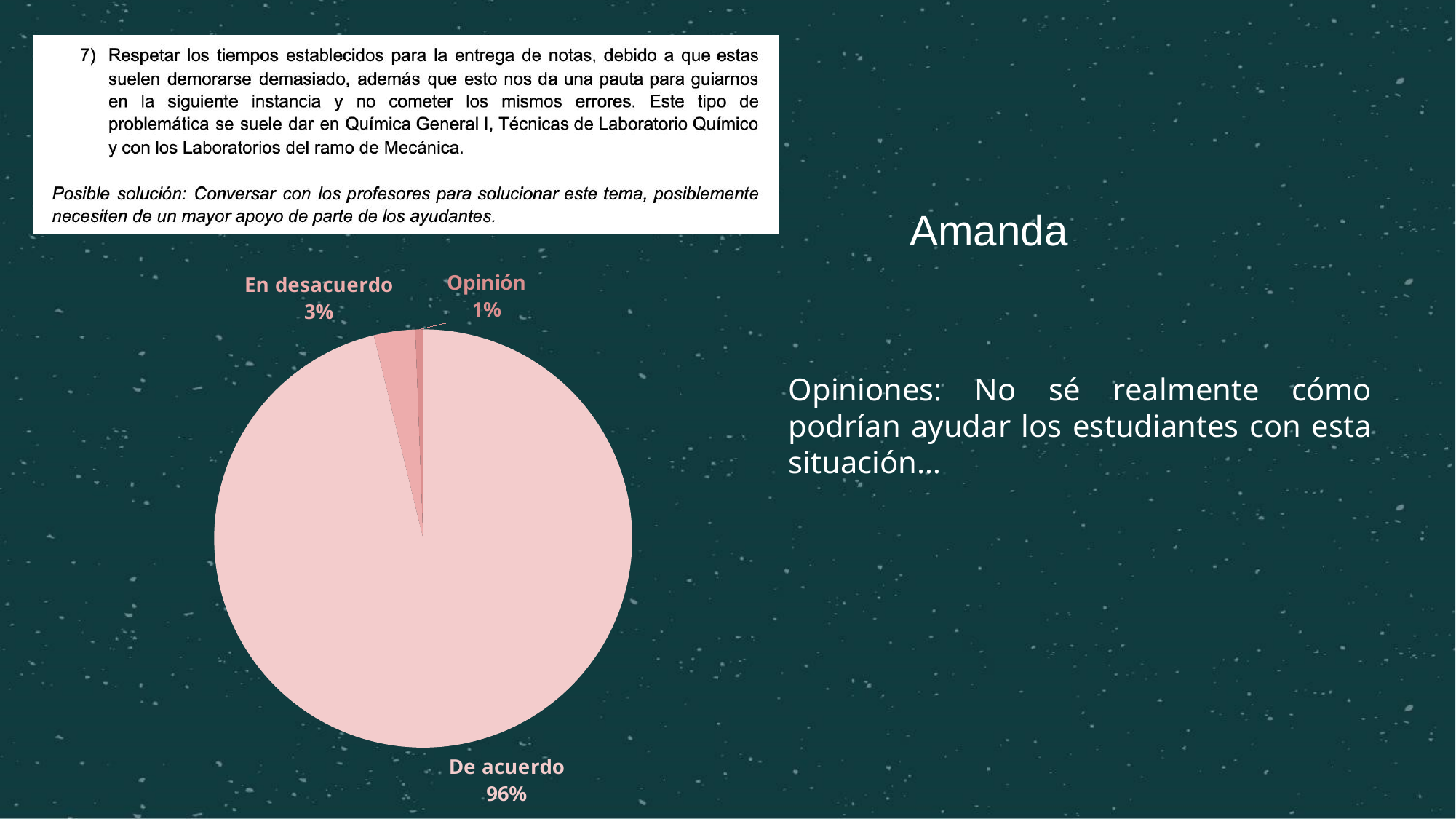
What is the difference in percentage points between "De acuerdo" and "En desacuerdo"? 93 What kind of chart is shown on the slide? Pie chart Which category has the smallest slice of the pie? Opinión What name appears as the heading on the right side of the slide? Amanda Which category has the largest slice of the pie? De acuerdo What share of the pie does "De acuerdo" represent? 96% How many categories are shown in the pie chart? 3 What share of the pie does "Opinión" represent? 1% What is the combined share of "En desacuerdo" and "Opinión"? 4% Which is larger, the slice for "En desacuerdo" or the slice for "Opinión"? En desacuerdo What is the difference in percentage points between "En desacuerdo" and "Opinión"? 2 What share of the pie does "En desacuerdo" represent? 3%